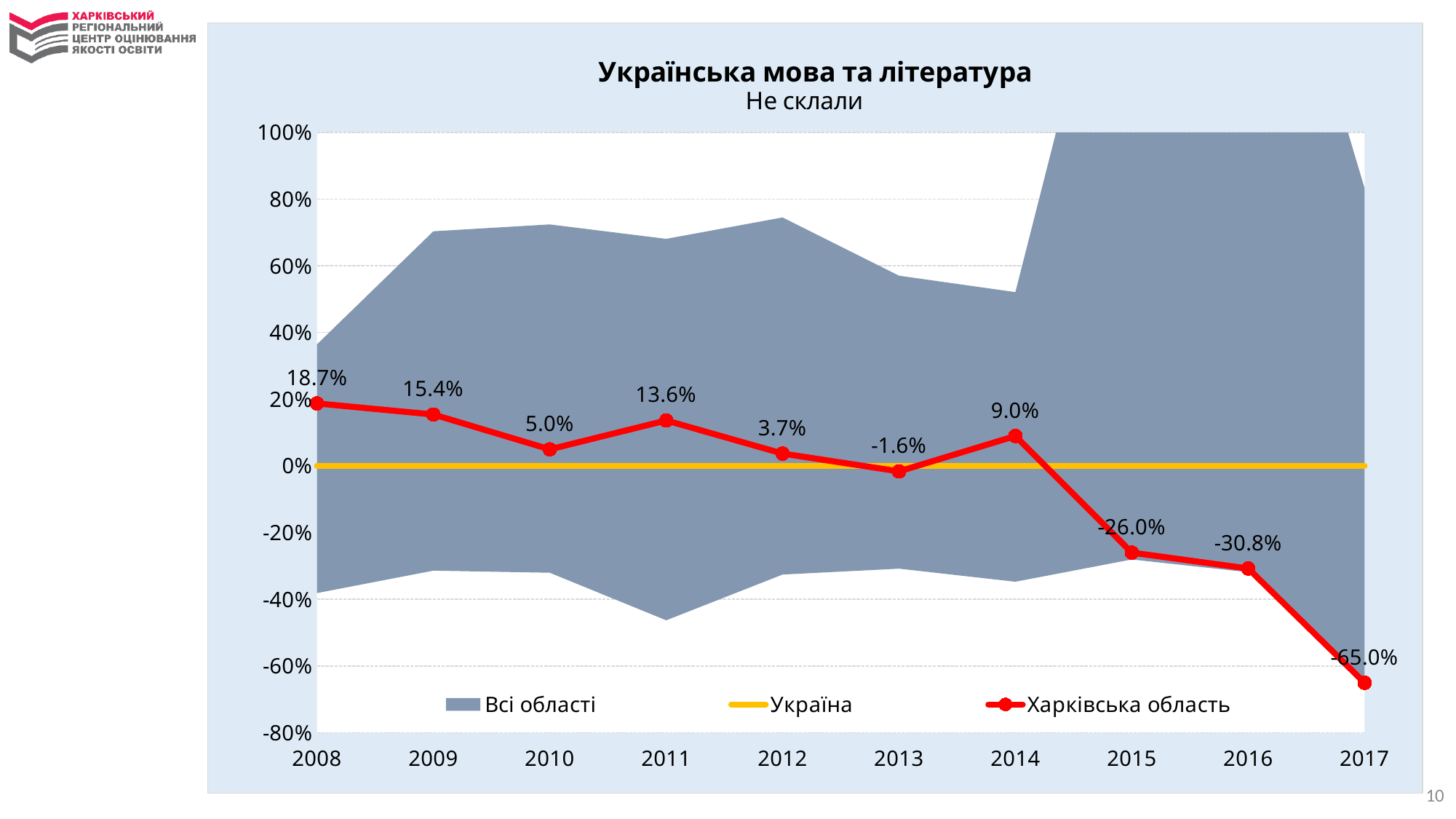
Does the Харківська область line rise or fall from 2014 to 2017? fall What is the value for Харківська область in 2014? 9.0% How many years are shown on the x axis? 10 In which year is the value for Харківська область highest? 2008 What is the value for Харківська область in 2008? 18.7% Which year has the larger value for Харківська область, 2011 or 2012? 2011 What is the value for Харківська область in 2017? -65.0% In which year is the value for Харківська область lowest? 2017 Is the value for Харківська область in 2015 greater or less than -20%? less What is the difference between the Харківська область values for 2008 and 2009? 3.3% What is the title of the chart? Українська мова та література How many series does the legend list? 3